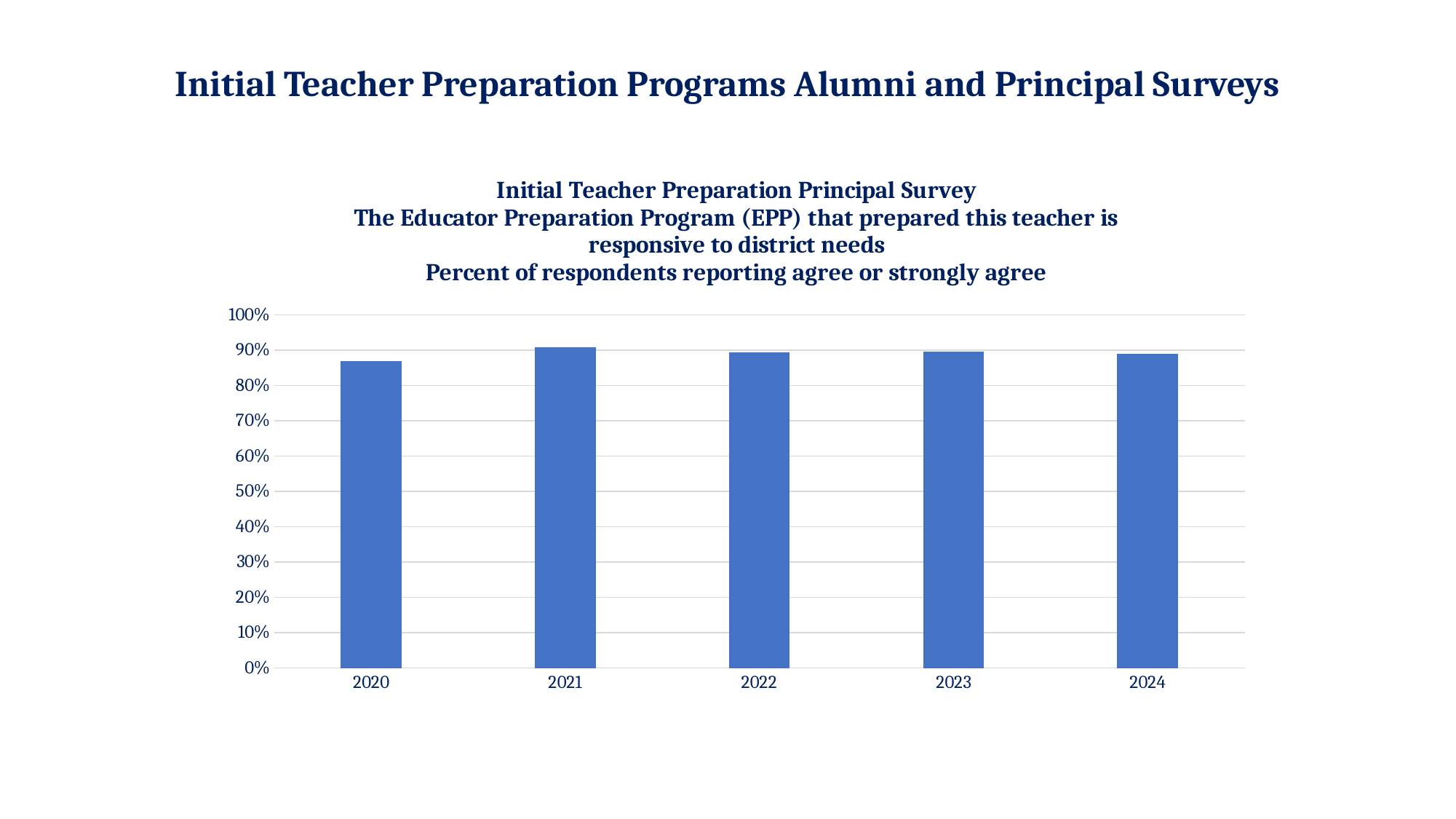
Does the value rise or fall from 2020 to 2021? rise Is the value for 2024 greater or less than 80%? greater How many years are shown on the x axis of the chart? 5 Which year has the lowest percentage of respondents reporting agree or strongly agree? 2020 What kind of chart is shown on the slide? bar chart Is the value for 2020 greater or less than 90%? less Which year has the highest percentage of respondents reporting agree or strongly agree? 2021 Is the value for 2022 greater or less than 50%? greater What is the highest value shown on the y axis? 100% Which year has the larger value, 2020 or 2021? 2021 What is the first line of the chart's title? Initial Teacher Preparation Principal Survey